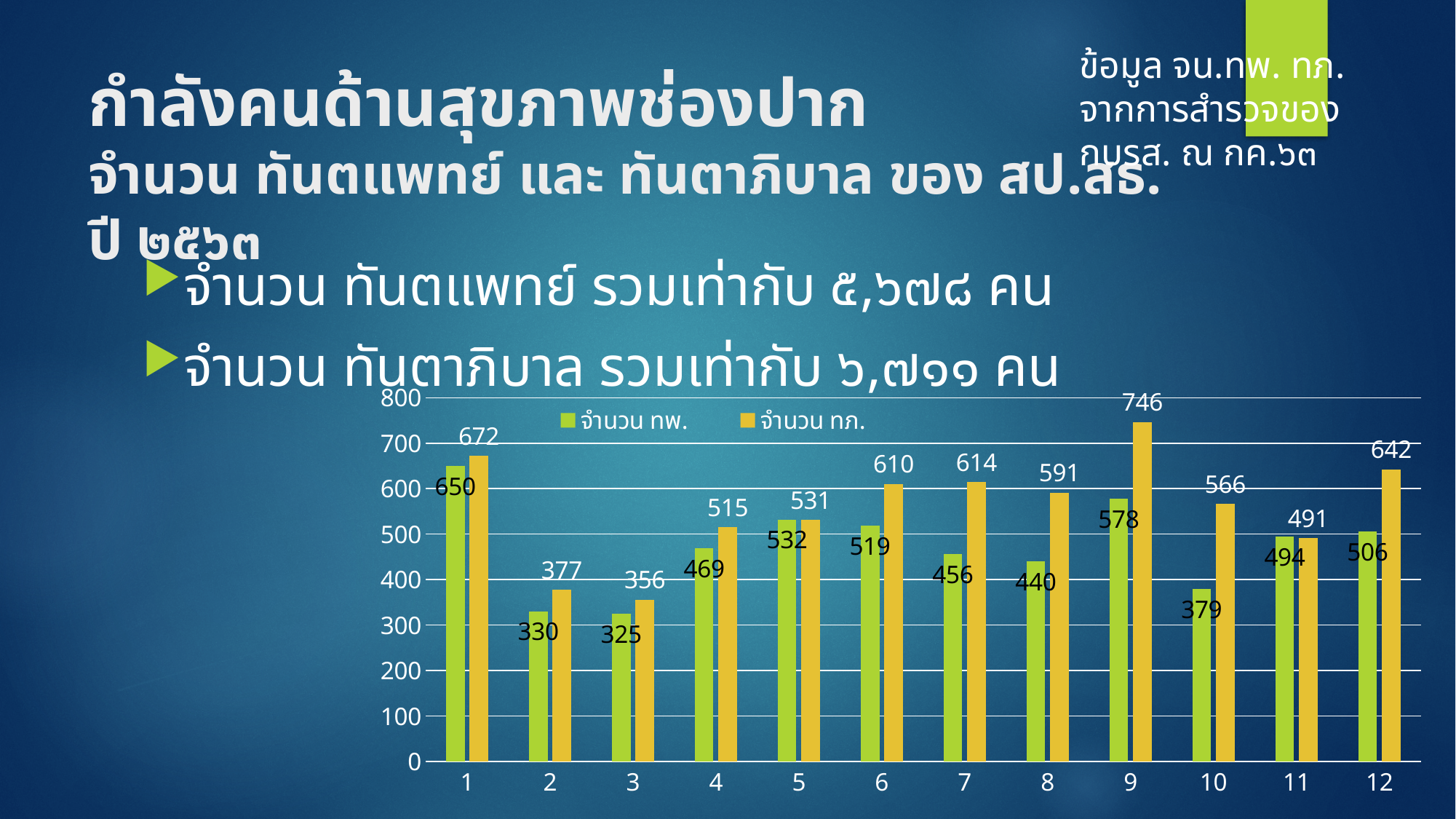
What is the value of จำนวน ทก. for category 12? 642 What is the value of จำนวน ทพ. for category 10? 379 What is the value of จำนวน ทพ. for category 1? 650 Which category has the highest value for จำนวน ทก.? 9 Which category has the lowest value for จำนวน ทพ.? 3 Which is larger for category 6: จำนวน ทพ. or จำนวน ทก.? จำนวน ทก. How many series does the legend list? 2 What is the value of จำนวน ทก. for category 9? 746 What kind of chart is shown on the slide? bar chart Which colour represents จำนวน ทพ. in the chart? green How many categories are shown on the x axis? 12 What is the difference between จำนวน ทก. and จำนวน ทพ. for category 9? 168